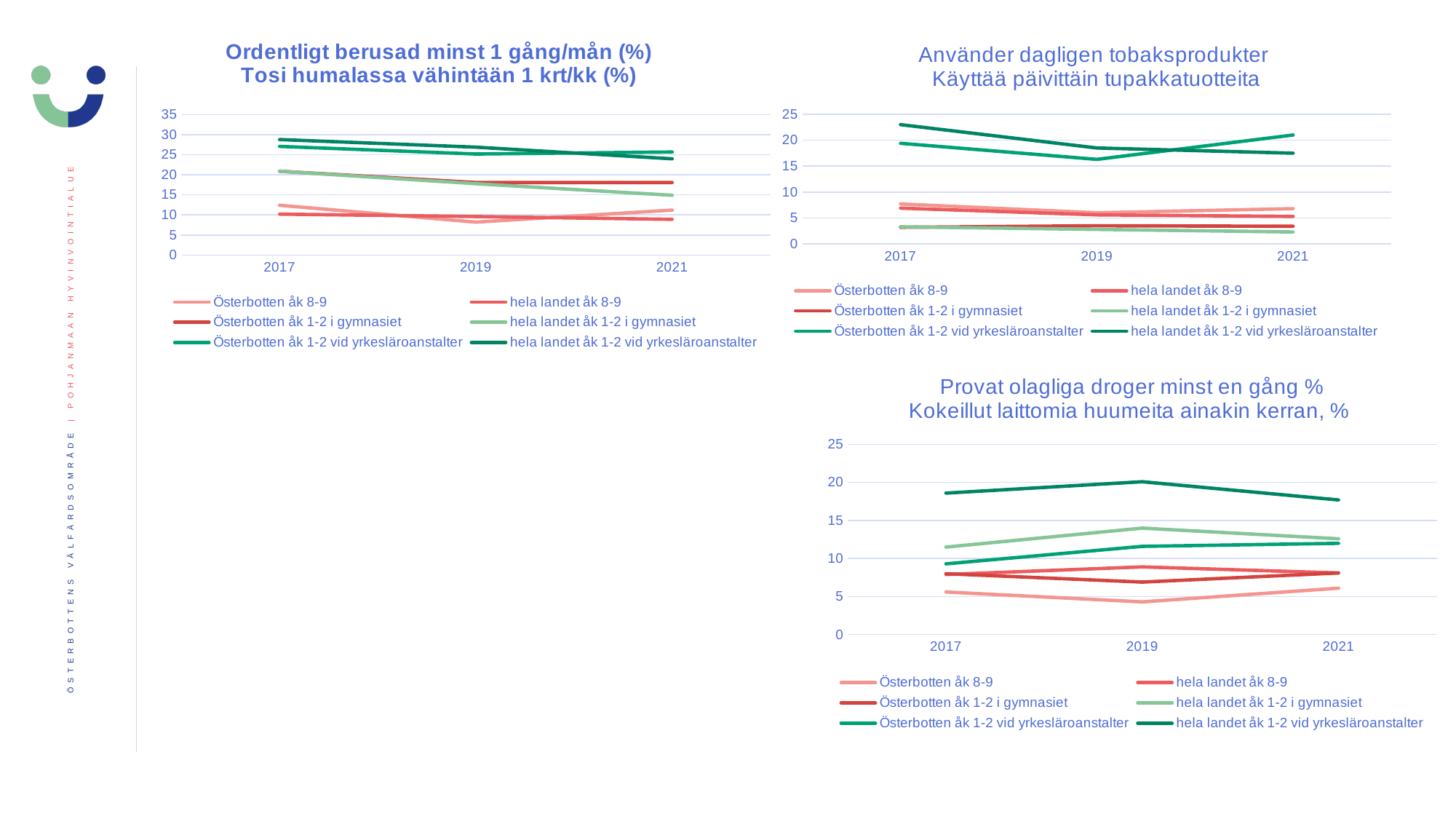
How many years are shown on the x axis of the "Provat olagliga droger minst en gång %" chart? 3 What kind of chart is the "Ordentligt berusad minst 1 gång/mån (%)" chart? line chart In the "Använder dagligen tobaksprodukter" chart, does the value for Österbotten åk 1-2 vid yrkesläroanstalter rise or fall from 2019 to 2021? rise In the "Använder dagligen tobaksprodukter" chart, which series has the highest value in 2021? Österbotten åk 1-2 vid yrkesläroanstalter What is the highest value shown on the y axis of the "Ordentligt berusad minst 1 gång/mån (%)" chart? 35 How many series does the legend of the "Använder dagligen tobaksprodukter" chart list? 6 In the "Provat olagliga droger minst en gång %" chart, which is larger in 2021: hela landet åk 1-2 vid yrkesläroanstalter or hela landet åk 1-2 i gymnasiet? hela landet åk 1-2 vid yrkesläroanstalter In the "Provat olagliga droger minst en gång %" chart, which series has the lowest value in 2019? Österbotten åk 8-9 In the "Ordentligt berusad minst 1 gång/mån (%)" chart, does the value for hela landet åk 1-2 i gymnasiet rise or fall from 2017 to 2021? fall In the "Använder dagligen tobaksprodukter" chart, is the 2019 value for Österbotten åk 1-2 vid yrkesläroanstalter greater or less than 20? less In the "Ordentligt berusad minst 1 gång/mån (%)" chart, is the 2017 value for hela landet åk 1-2 vid yrkesläroanstalter greater or less than 25? greater In the "Provat olagliga droger minst en gång %" chart, is the 2019 value for Österbotten åk 8-9 greater or less than 5? less